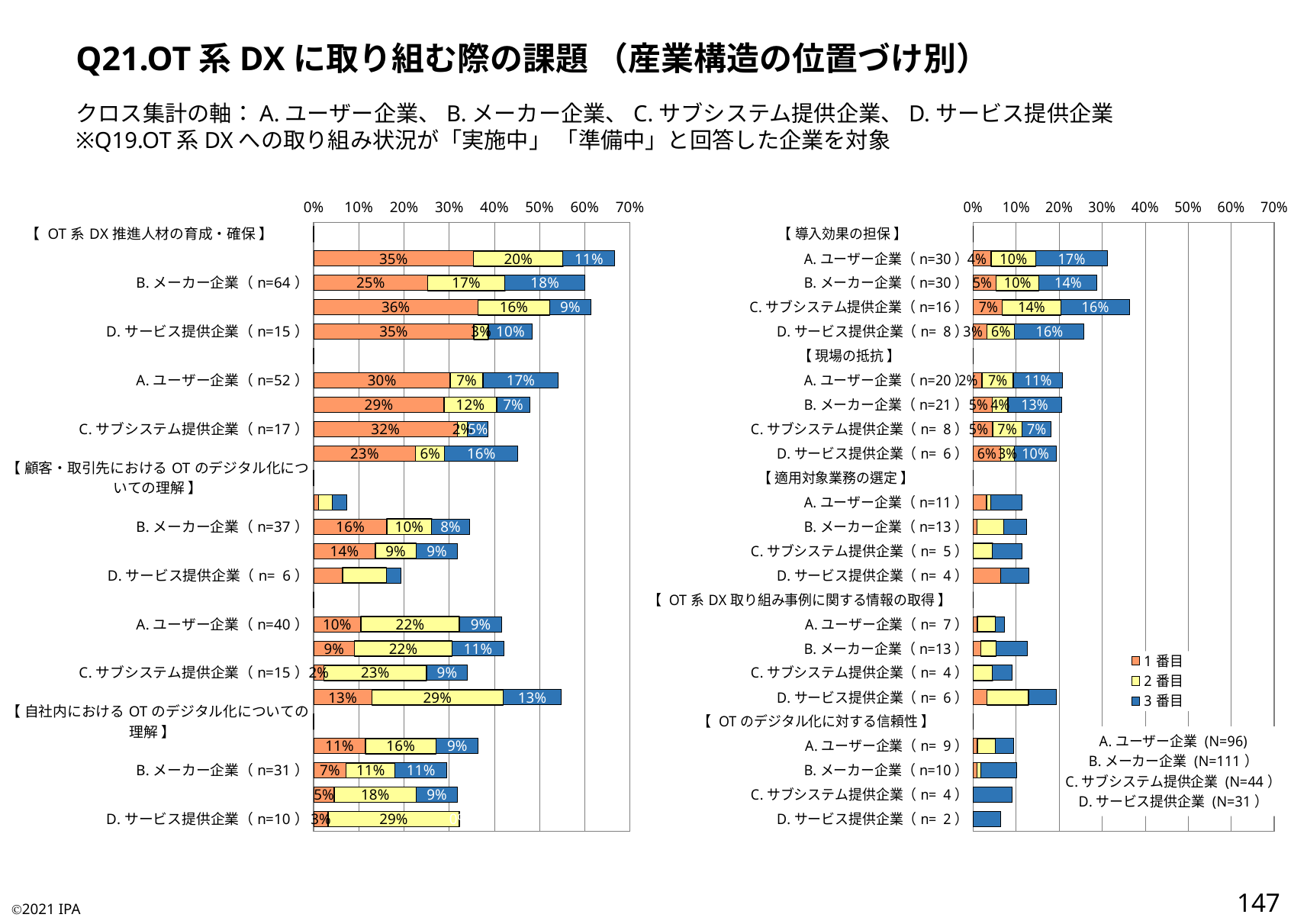
In the left chart, under 【OT系DX推進人材の育成・確保】, what is the 1番目 value for B. メーカー企業 (n=64)? 25% What are the three legend entries shown on the right chart? 1番目, 2番目, 3番目 In the right chart, under 【導入効果の担保】, what is the 3番目 value for C. サブシステム提供企業 (n=16)? 16% In the left chart, under 【OT系DX推進人材の育成・確保】, what is the total of the stacked bar for D. サービス提供企業 (n=15)? 48% In the left chart, under 【自社内におけるOTのデジタル化についての理解】, what is the 2番目 value for B. メーカー企業 (n=31)? 11% In the right chart, under 【導入効果の担保】, which company type has the highest 1番目 value? C. サブシステム提供企業 (n=16) How many series does the legend on the right chart list? 3 What kind of chart is used on this slide? Stacked bar chart In the right chart, under 【導入効果の担保】, what is the total of the stacked bar for A. ユーザー企業 (n=30)? 31% In the left chart, for A. ユーザー企業 (n=40), how much larger is the 2番目 value than the 1番目 value? 12 percentage points In the right chart, under 【現場の抵抗】, which has the larger 3番目 value: B. メーカー企業 (n=21) or C. サブシステム提供企業 (n=8)? B. メーカー企業 (n=21) In the right chart, under 【適用対象業務の選定】, is the total bar for D. サービス提供企業 (n=4) greater or less than 20%? less